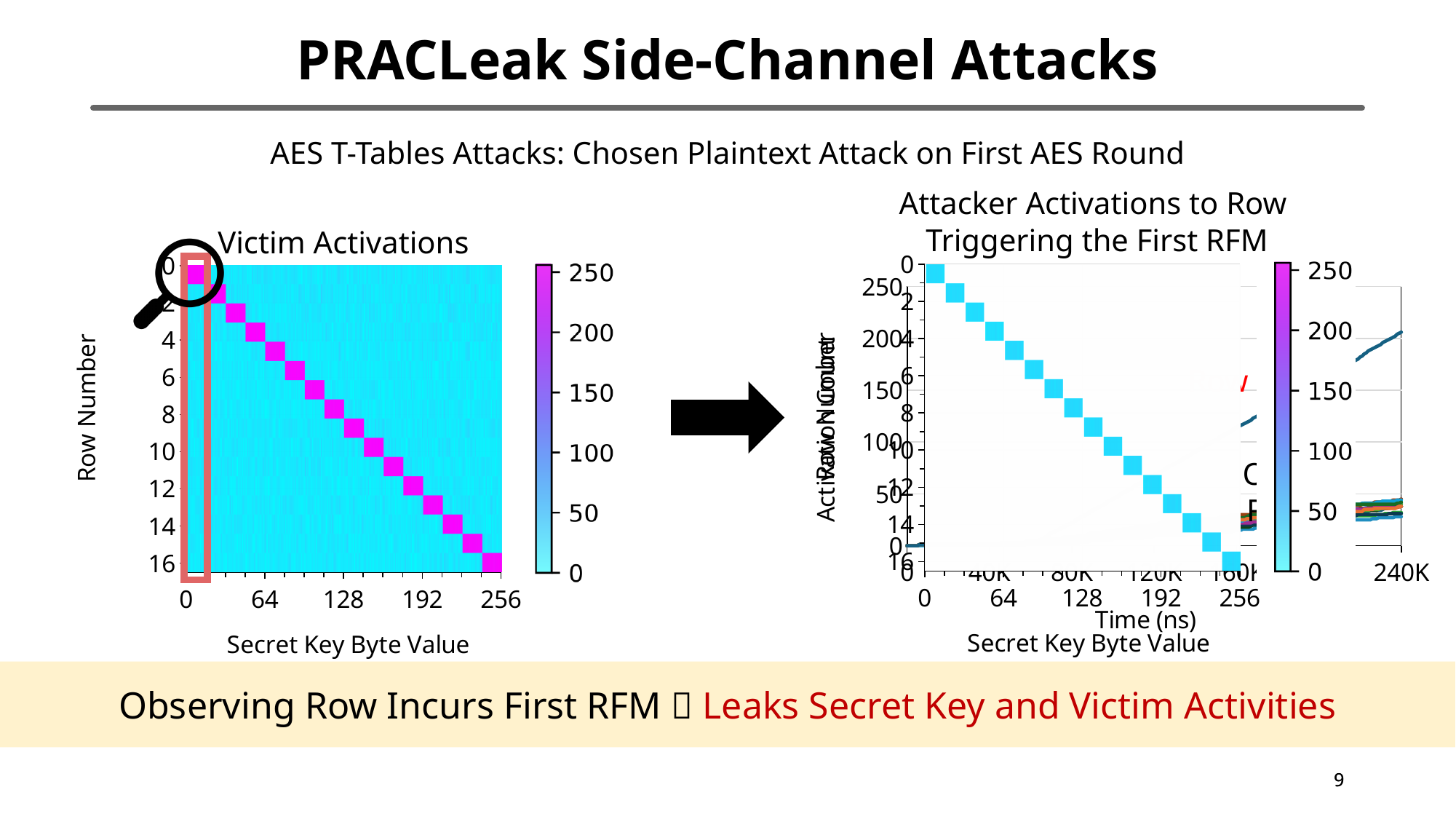
In the 'Victim Activations' chart, is the value at row 8 for secret key byte value 0 greater or less than 50? less What kind of chart is the 'Victim Activations' chart? heatmap In the 'Victim Activations' chart, as the secret key byte value increases, does the row number with the highest activations rise or fall? rise In the 'Victim Activations' chart, is the value at row 0 for secret key byte value 0 greater or less than 200? greater In the 'Attacker Activations to Row Triggering the First RFM' chart, as the secret key byte value increases, does the row number of the light-coloured (lowest) cells rise or fall? rise In the 'Victim Activations' chart, for secret key byte value 256, which row has the larger value: row 16 or row 0? row 16 In the 'Victim Activations' chart, for secret key byte value 0, which row has the larger value: row 0 or row 16? row 0 In the 'Victim Activations' chart, what is the highest value labelled on the colour bar? 250 In the 'Victim Activations' chart, what is the label of the x axis? Secret Key Byte Value What kind of chart is the 'Attacker Activations to Row Triggering the First RFM' chart? heatmap